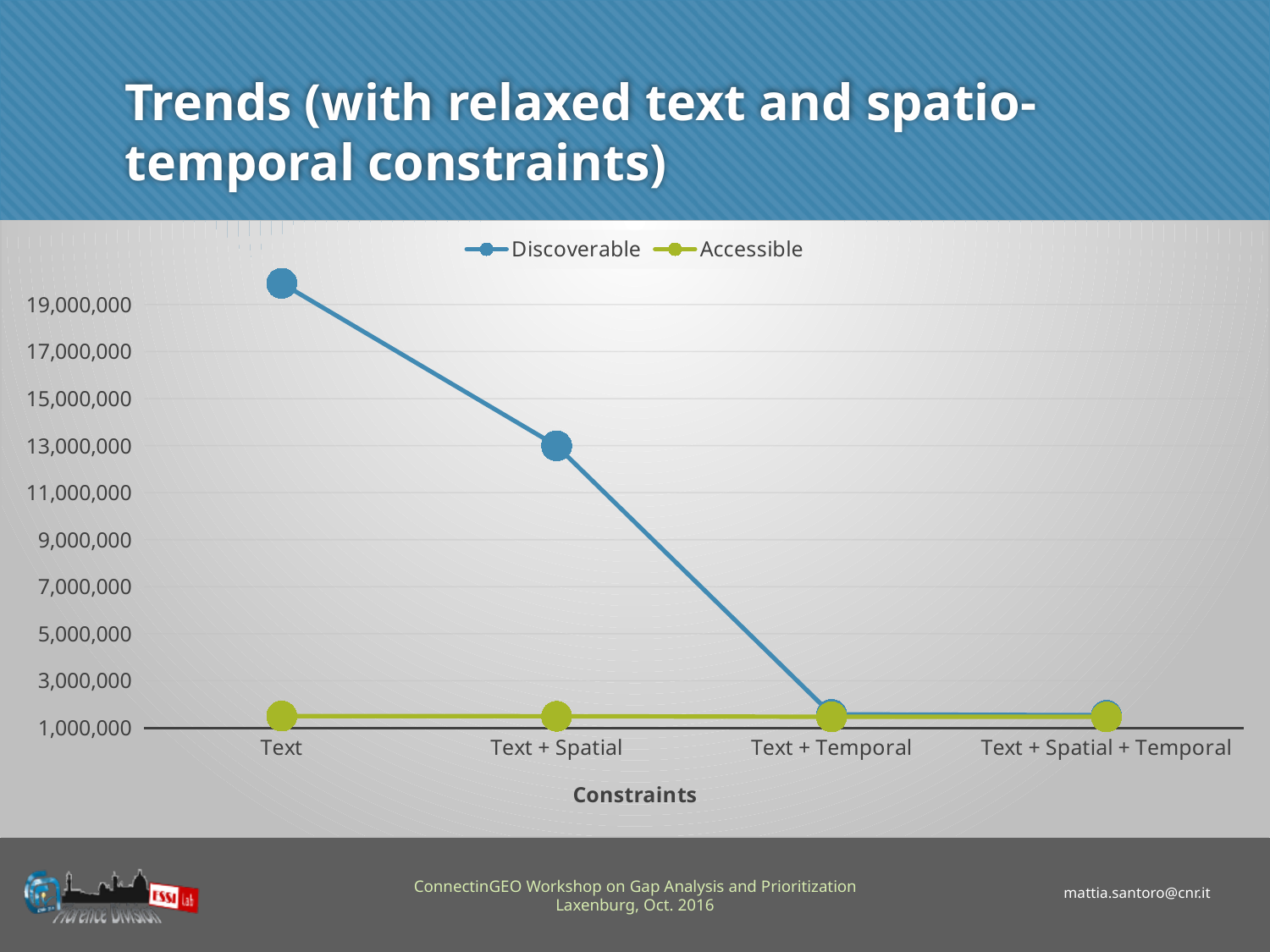
Does the Discoverable series rise or fall from Text to Text + Temporal? fall What kind of chart is shown on the slide? line chart Is the Discoverable value for Text + Spatial greater or less than 11,000,000? greater Which is larger at Text + Spatial: the Discoverable value or the Accessible value? Discoverable Is the Discoverable value for Text + Temporal greater or less than 3,000,000? less How many categories are shown on the x axis? 4 Is the Discoverable value for Text greater or less than 19,000,000? greater What are the two series named in the legend? Discoverable and Accessible What is the title of the x axis? Constraints Which category has the highest value for the Discoverable series? Text How many series does the legend list? 2